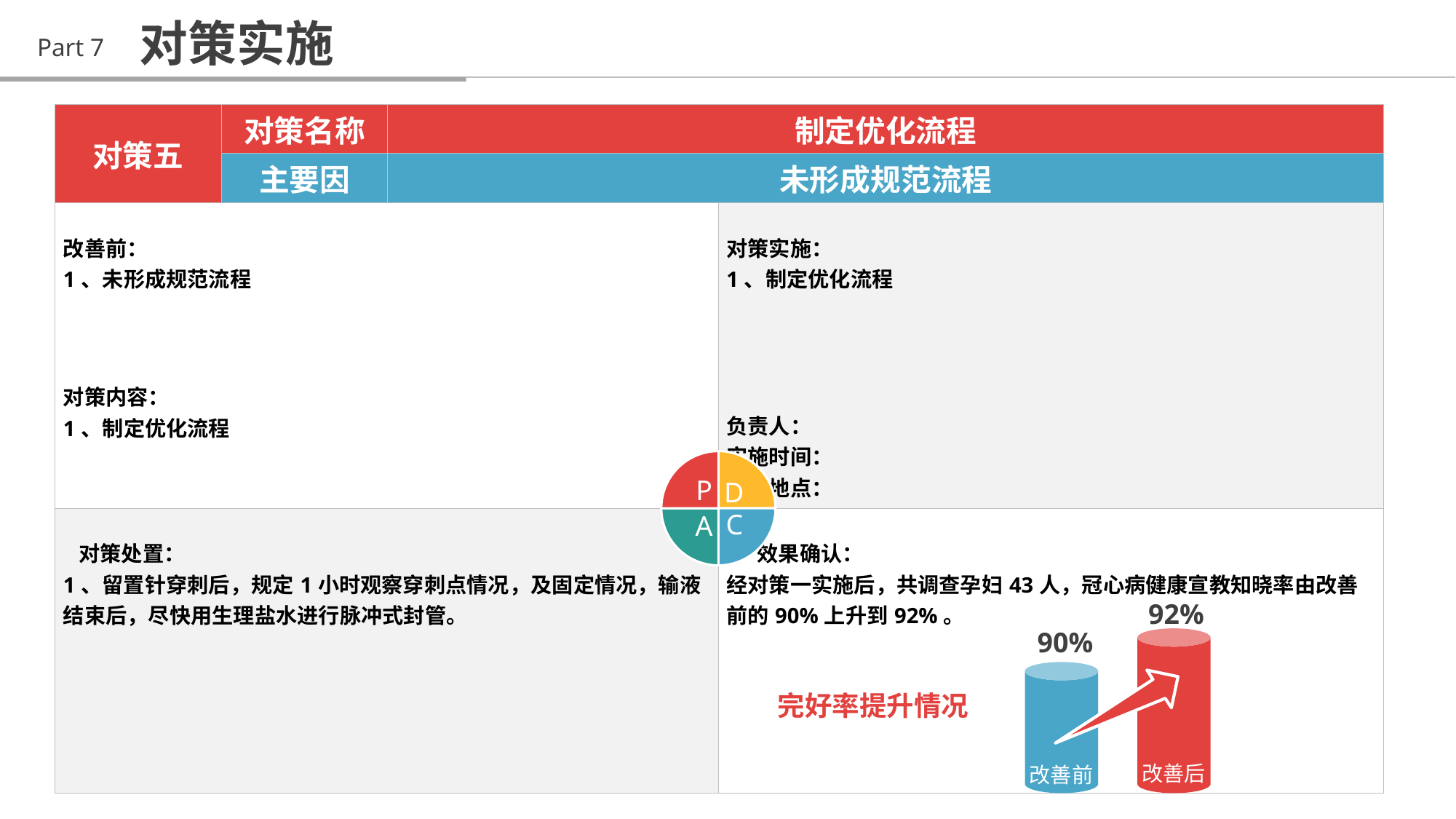
Which category has the lowest value in the chart? 改善前 What is the value for 改善前 in the chart? 90% What colour is the bar for 改善后? red Which category has the higher value, 改善前 or 改善后? 改善后 What is the difference between the values for 改善后 and 改善前? 2% How many categories are shown in the chart? 2 What is the value for 改善后 in the chart? 92% Do the values rise or fall from 改善前 to 改善后? rise Which category has the highest value in the chart? 改善后 What is the title of the chart? 完好率提升情况